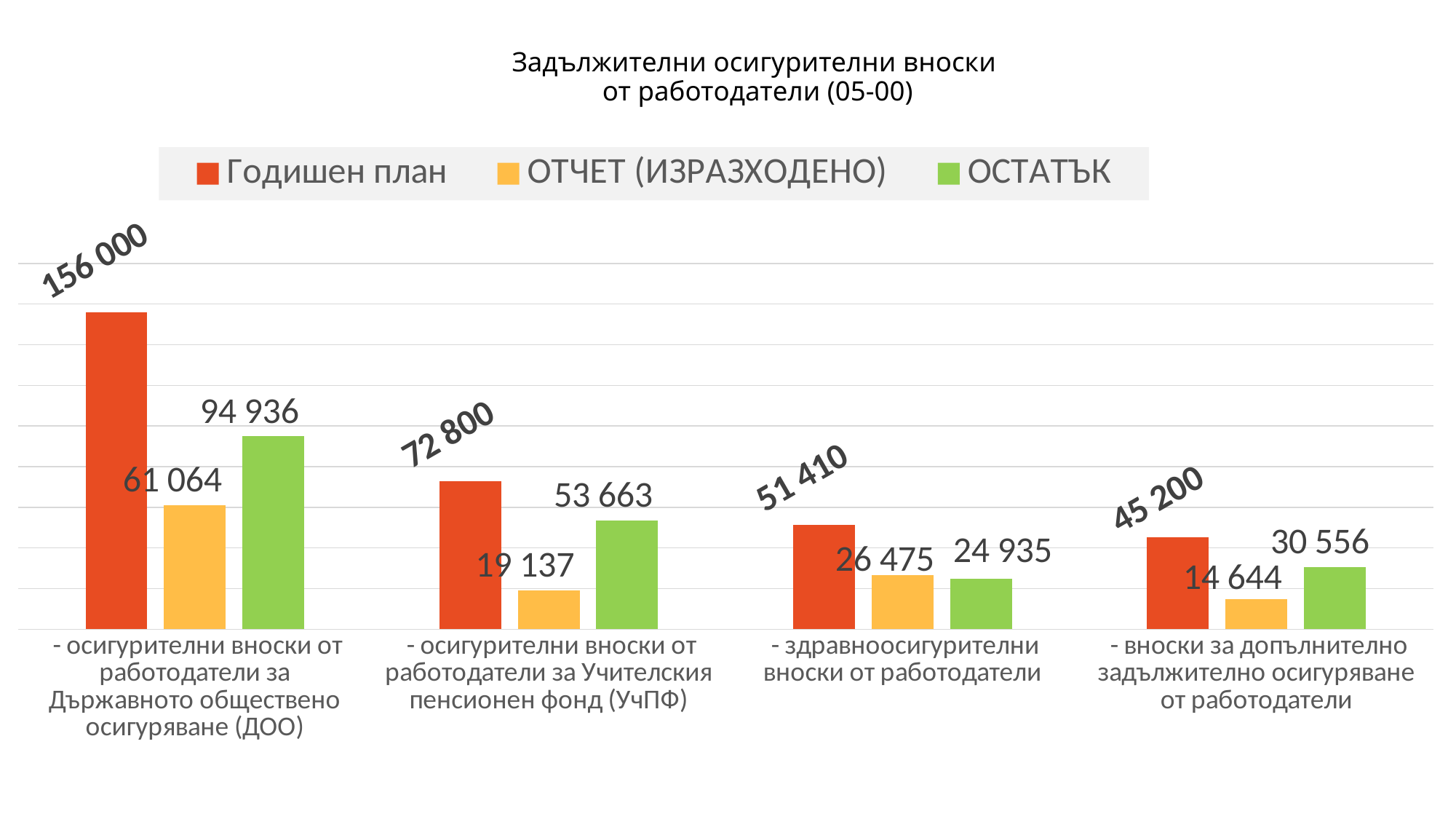
What kind of chart is shown on the slide? bar chart How many categories are shown on the x axis? 4 Which category has the lowest ОТЧЕТ (ИЗРАЗХОДЕНО) value? вноски за допълнително задължително осигуряване от работодатели What is the ОТЧЕТ (ИЗРАЗХОДЕНО) value for осигурителни вноски от работодатели за Учителския пенсионен фонд (УчПФ)? 19 137 What is the difference between the Годишен план and ОТЧЕТ (ИЗРАЗХОДЕНО) values for ДОО? 94 936 What is the difference between the Годишен план values for УчПФ and for вноски за допълнително задължително осигуряване от работодатели? 27 600 What is the ОСТАТЪК value for вноски за допълнително задължително осигуряване от работодатели? 30 556 For здравноосигурителни вноски от работодатели, which is larger: ОТЧЕТ (ИЗРАЗХОДЕНО) or ОСТАТЪК? ОТЧЕТ (ИЗРАЗХОДЕНО) Which category has the highest Годишен план value? осигурителни вноски от работодатели за Държавното обществено осигуряване (ДОО) What is the Годишен план value for здравноосигурителни вноски от работодатели? 51 410 What is the title of the chart? Задължителни осигурителни вноски от работодатели (05-00) How many series does the legend list? 3